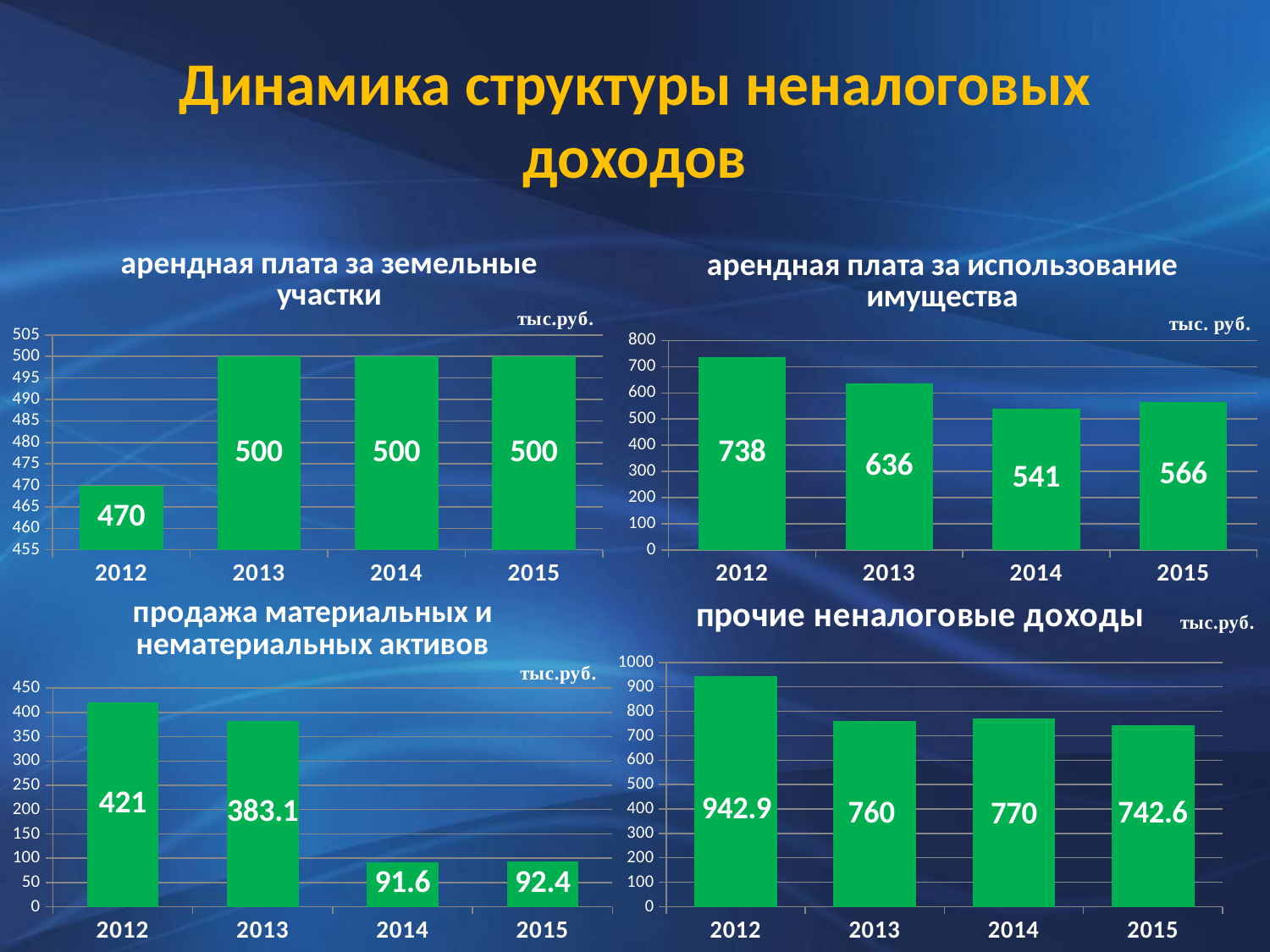
In the chart 'арендная плата за земельные участки', how many years are shown on the x axis? 4 What unit is shown on the charts? тыс.руб. In the chart 'прочие неналоговые доходы', what is the value for 2015? 742.6 In the chart 'арендная плата за использование имущества', which year has the lowest value? 2014 In the chart 'продажа материальных и нематериальных активов', what is the value for 2014? 91.6 In the chart 'продажа материальных и нематериальных активов', do the values generally rise or fall from 2012 to 2015? fall In the chart 'арендная плата за земельные участки', what is the value for 2012? 470 In the chart 'арендная плата за использование имущества', what is the value for 2013? 636 In the chart 'продажа материальных и нематериальных активов', what is the difference between the 2012 and 2013 values? 37.9 What kind of chart is 'прочие неналоговые доходы'? bar chart In the chart 'прочие неналоговые доходы', which is larger, the value for 2013 or the value for 2014? 2014 In the chart 'арендная плата за использование имущества', which year has the highest value? 2012